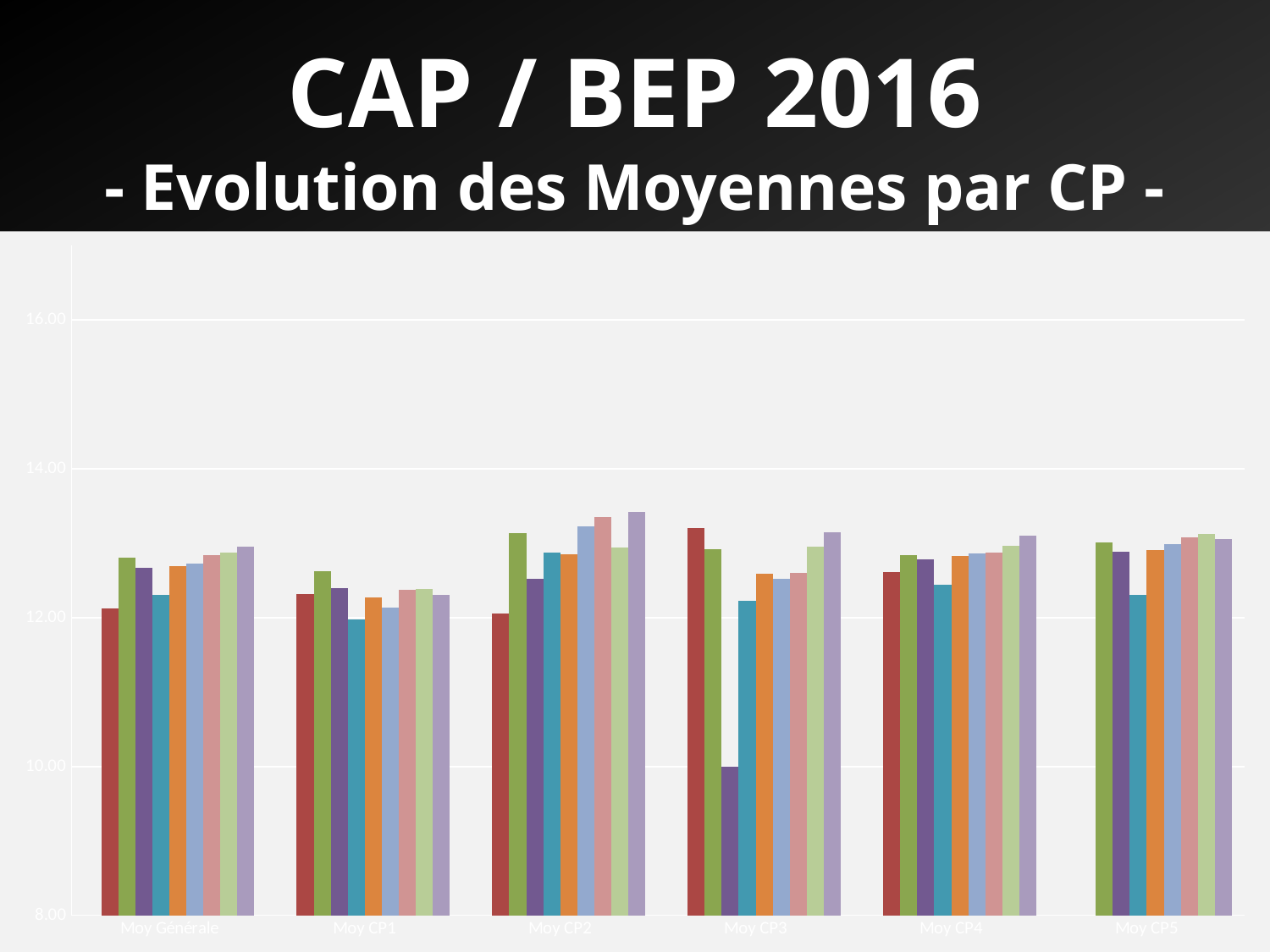
What is the title shown above the chart? CAP / BEP 2016 - Evolution des Moyennes par CP - Is the tallest bar for Moy CP2 greater or less than 12.00? greater Is the lowest bar for Moy CP3 greater or less than 12.00? less Which category contains the tallest bar in the chart? Moy CP2 Which category contains the lowest bar in the chart? Moy CP3 What is the highest value labelled on the y axis of the chart? 16.00 Are all the bars for Moy CP1 greater or less than 10.00? greater Which category has the lower minimum bar, Moy CP1 or Moy CP3? Moy CP3 How many categories are shown along the x axis of the chart? 6 What kind of chart is shown on the slide? Bar chart